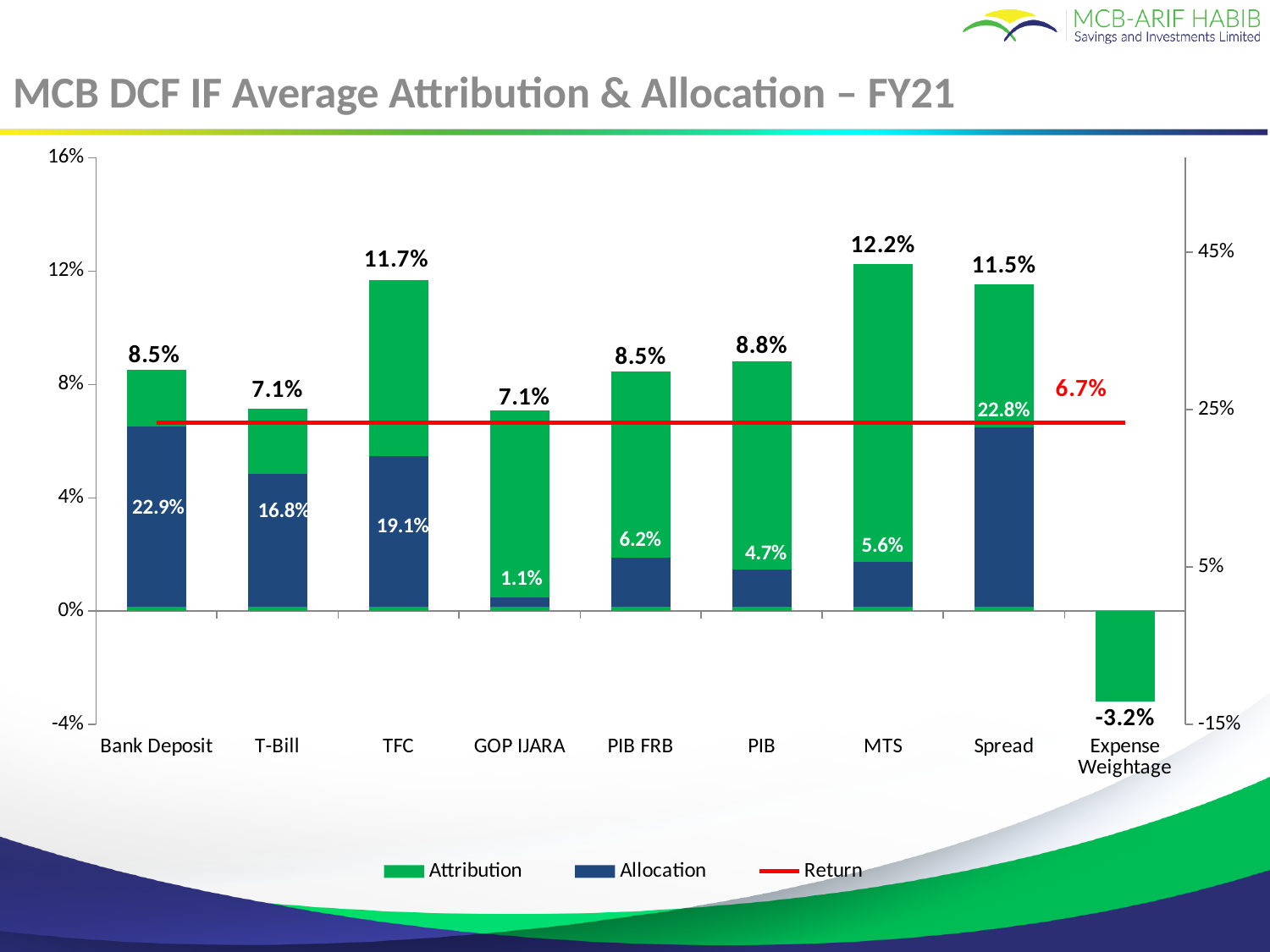
What kind of chart is this? Bar chart with a line What is the Return value shown by the red line? 6.7% How many categories are shown on the x axis? 9 How many series does the legend list? 3 What is the Attribution value for Expense Weightage? -3.2% What is the Attribution value for TFC? 11.7% Which category has the lowest Allocation value? GOP IJARA Which category has the highest Attribution value? MTS What is the difference between the Attribution values for MTS and Spread? 0.7% What is the Allocation value for Bank Deposit? 22.9% Which has a larger Allocation value, T-Bill or TFC? TFC What is the title of the chart? MCB DCF IF Average Attribution & Allocation – FY21